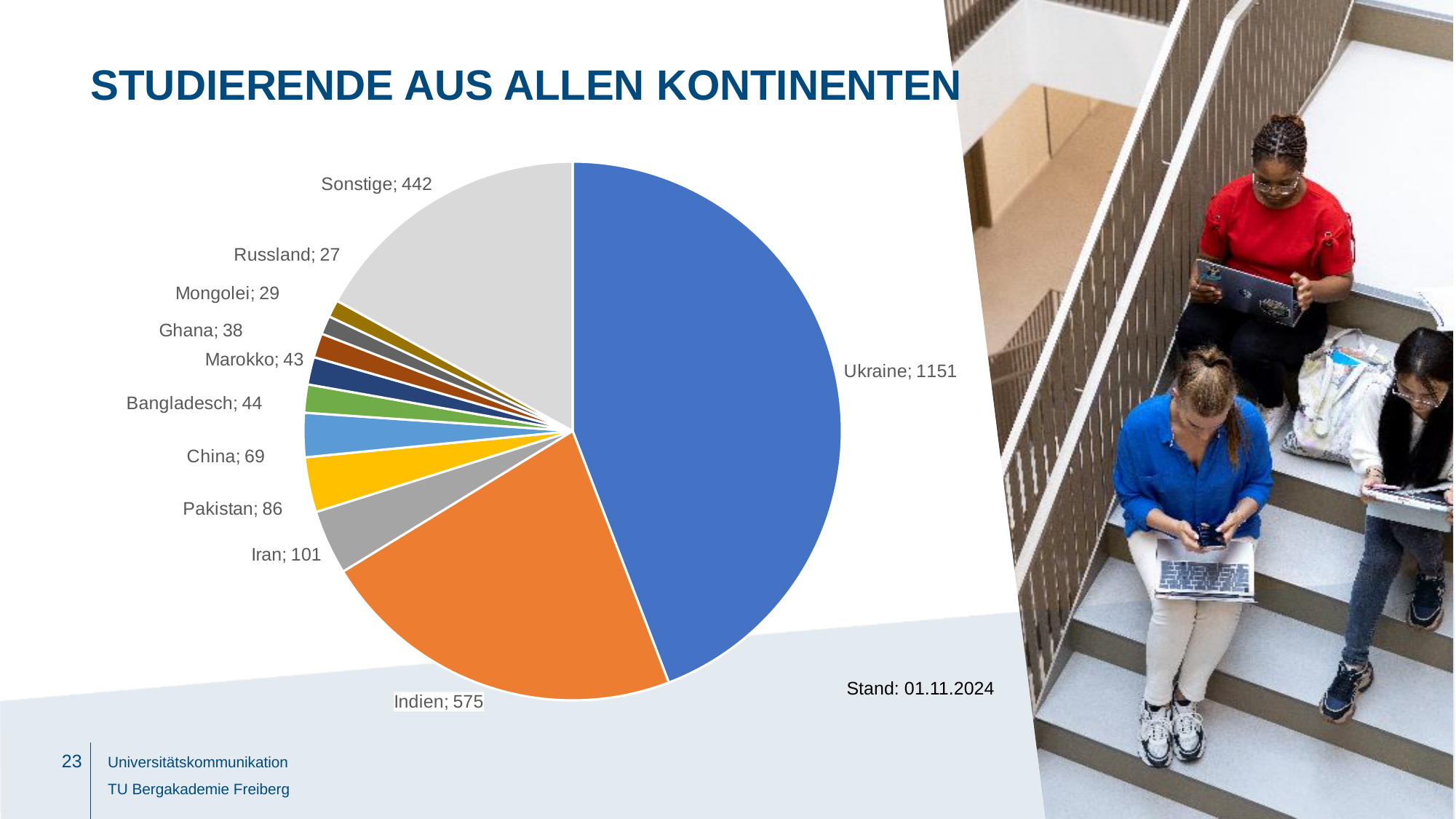
How many students are from Ukraine according to the chart? 1151 How many slices does the pie chart have? 11 What is the value shown for Indien? 575 What kind of chart is shown on the slide? pie chart What is the title of the slide containing the chart? STUDIERENDE AUS ALLEN KONTINENTEN What is the difference between the values for Iran and Pakistan? 15 Which country has the largest slice of the pie? Ukraine What is the difference between the values for Ukraine and Indien? 576 What is the value shown for China? 69 What is the value shown for Sonstige? 442 Which labelled category has the smallest value in the chart? Russland Which is larger, the value for Bangladesch or the value for Ghana? Bangladesch